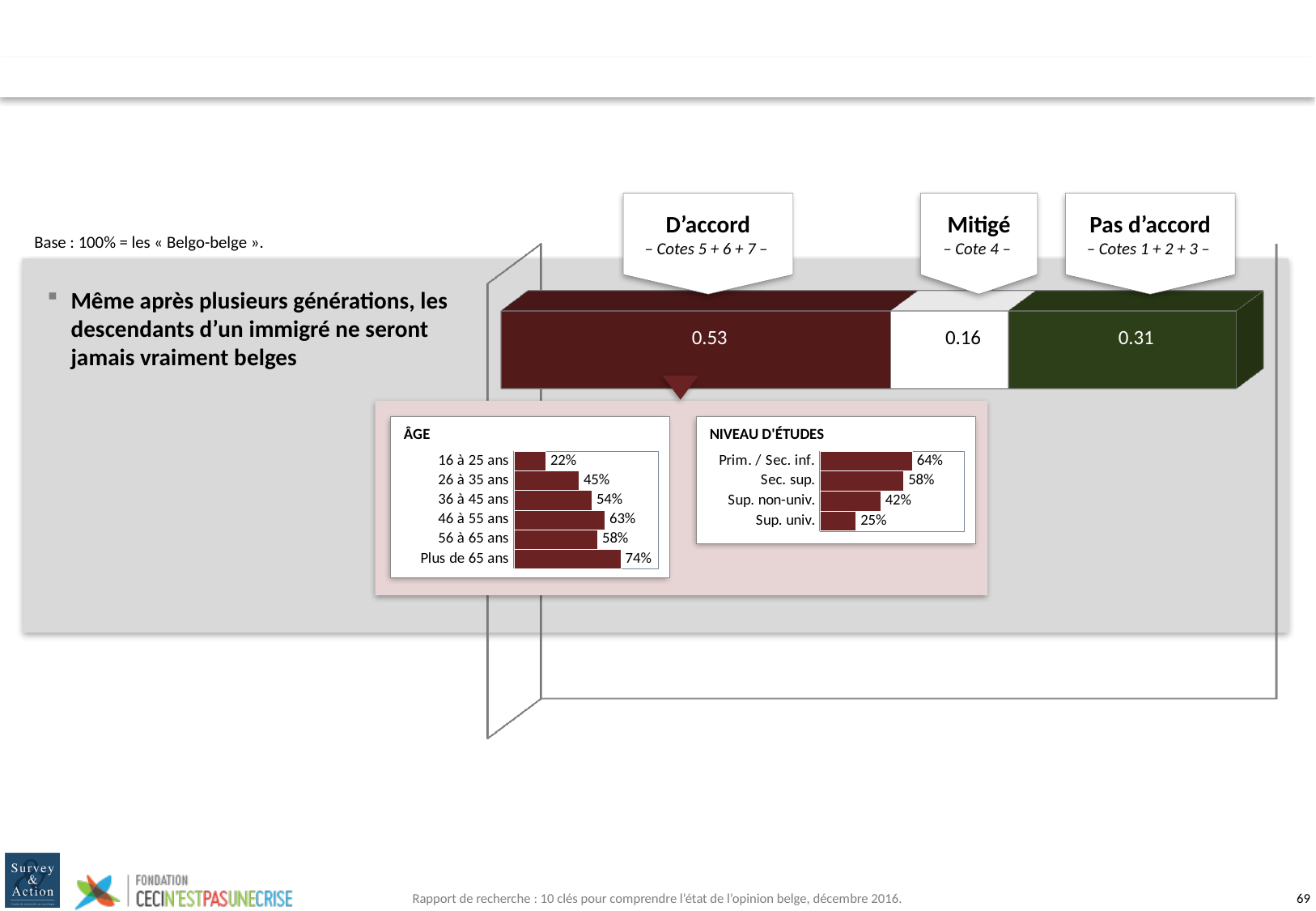
In the NIVEAU D'ÉTUDES chart, which category has the highest value? Prim. / Sec. inf. In the NIVEAU D'ÉTUDES chart, do the values rise or fall as the level of education increases from "Prim. / Sec. inf." to "Sup. univ."? fall In the main stacked bar, what is the value for "Mitigé"? 0.16 In the ÂGE chart, which age group has the lowest value? 16 à 25 ans In the ÂGE chart, how many age categories are shown? 6 In the ÂGE chart, what is the value for "Plus de 65 ans"? 74% What kind of chart is the ÂGE chart? bar chart In the main stacked bar, which segment is the largest? D'accord In the ÂGE chart, what is the difference between "46 à 55 ans" and "26 à 35 ans"? 18% In the NIVEAU D'ÉTUDES chart, what is the value for "Sup. non-univ."? 42% In the main stacked bar, what is the value for "D'accord"? 0.53 In the main stacked bar, what is the difference between "D'accord" and "Pas d'accord"? 0.22